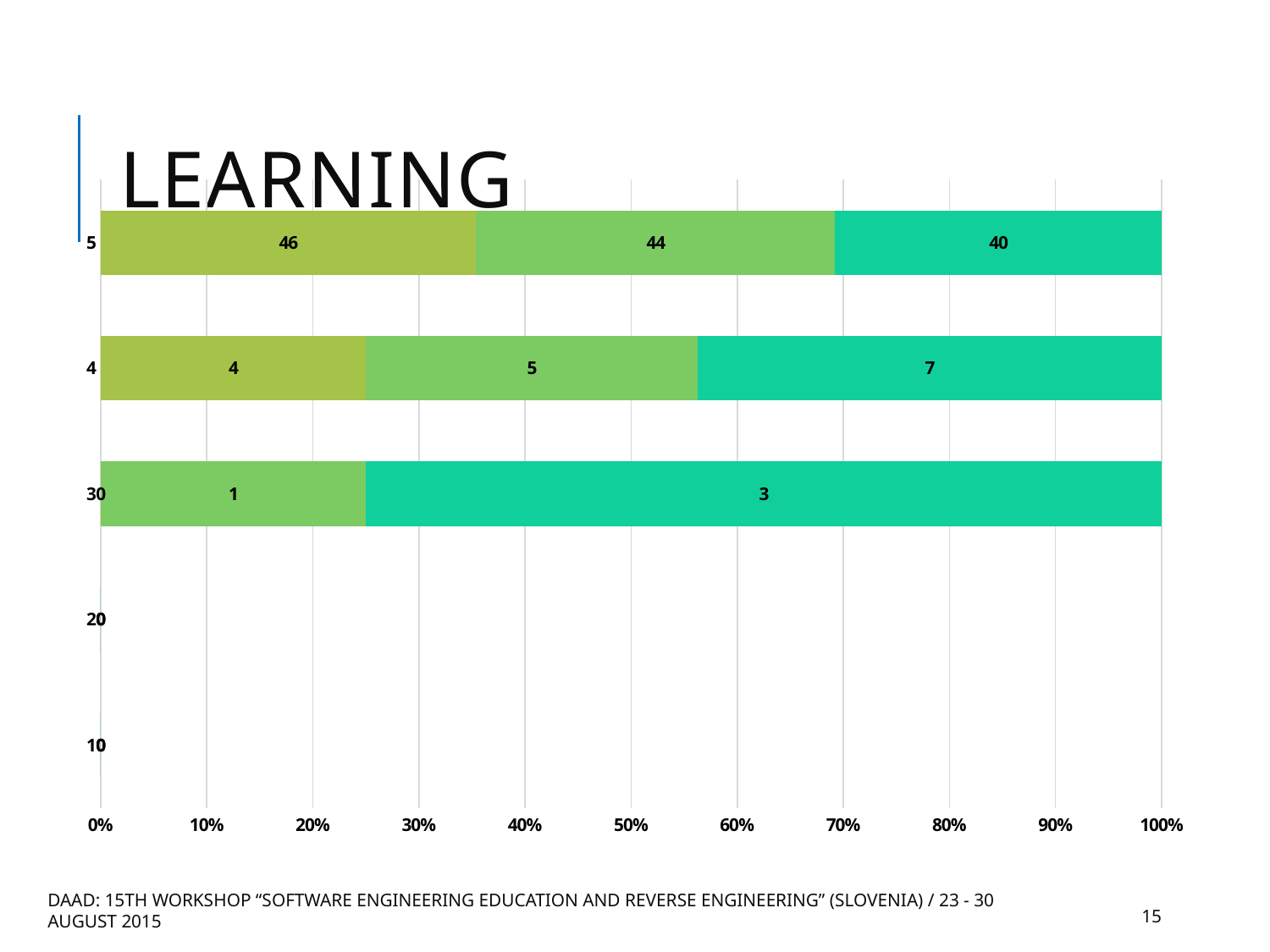
What is the value of the first (leftmost) segment of the bar labelled 5? 46 What is the difference between the first segment (46) and the last segment (40) of the bar labelled 5? 6 How many category labels are shown on the vertical axis? 5 What kind of chart is shown on the slide? Stacked bar chart In the bar labelled 4, which is larger: the first segment or the last segment? The last segment (7) What is the total of the three segments in the bar labelled 4? 16 What is the value of the middle segment of the bar labelled 4? 5 What is the highest value shown on the horizontal axis? 100% What is the title of the chart? LEARNING Is the share of the first segment in the bar labelled 5 greater or less than 30%? greater What is the value of the last (rightmost) segment of the bar labelled 5? 40 What is the total of the three segments in the bar labelled 5? 130